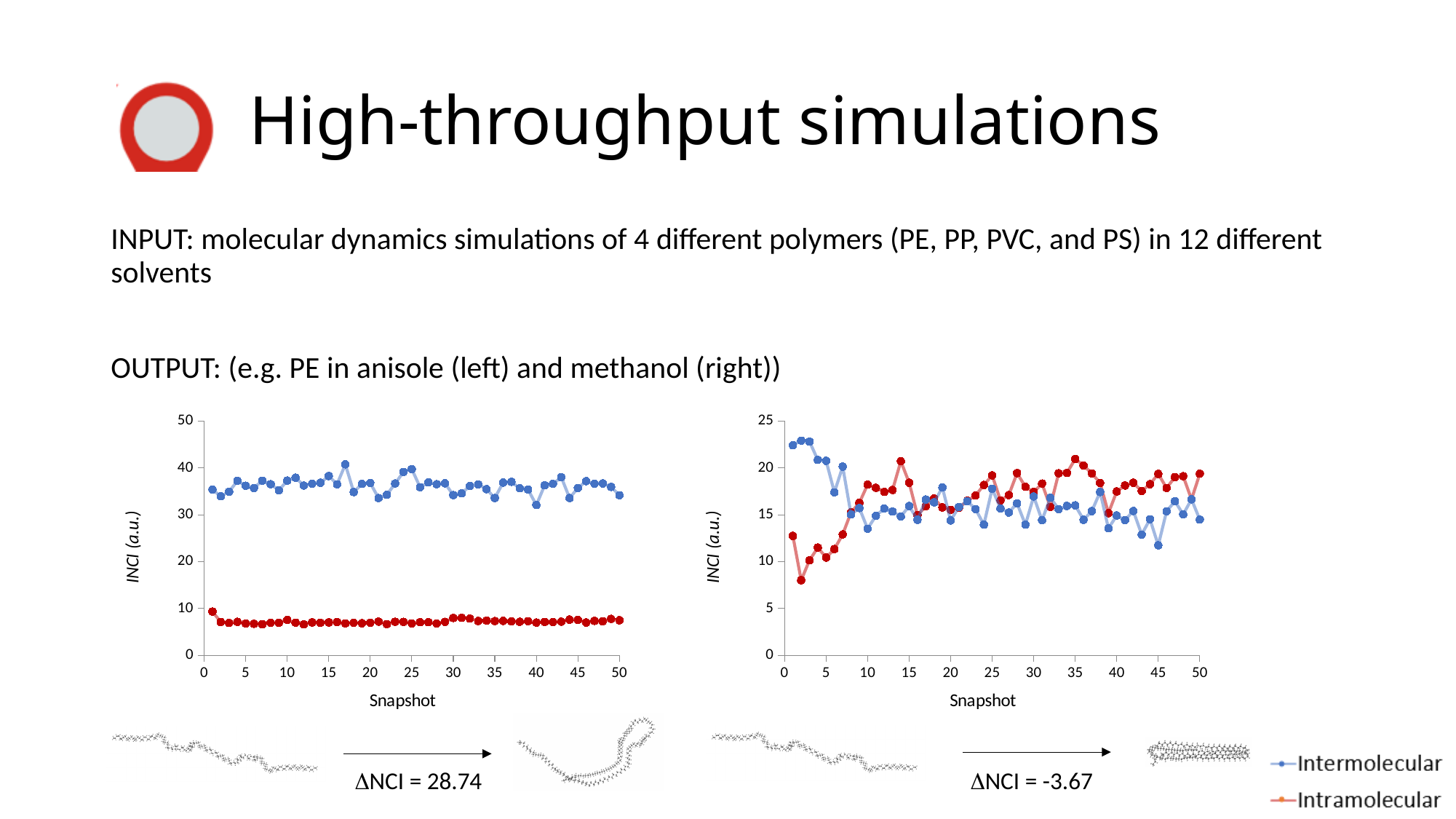
In the left chart (PE in anisole), is the Intramolecular value at snapshot 25 greater or less than 20? less In the right chart (PE in methanol), is the Intermolecular value at snapshot 1 greater or less than 20? greater In the right chart (PE in methanol), which series has the larger value at snapshot 35, Intermolecular or Intramolecular? Intramolecular In the right chart (PE in methanol), does the Intermolecular series overall rise or fall from snapshot 1 to snapshot 50? fall In the right chart (PE in methanol), does the Intramolecular series overall rise or fall from snapshot 1 to snapshot 50? rise What kind of chart is the left chart (PE in anisole)? line chart In the left chart (PE in anisole), which series has the larger value at snapshot 20, Intermolecular or Intramolecular? Intermolecular What are the two series named in the legend? Intermolecular and Intramolecular What is the label of the x axis on the left chart (PE in anisole)? Snapshot In the right chart (PE in methanol), is the Intramolecular value at snapshot 2 greater or less than 10? less How many series does the legend list for the charts? 2